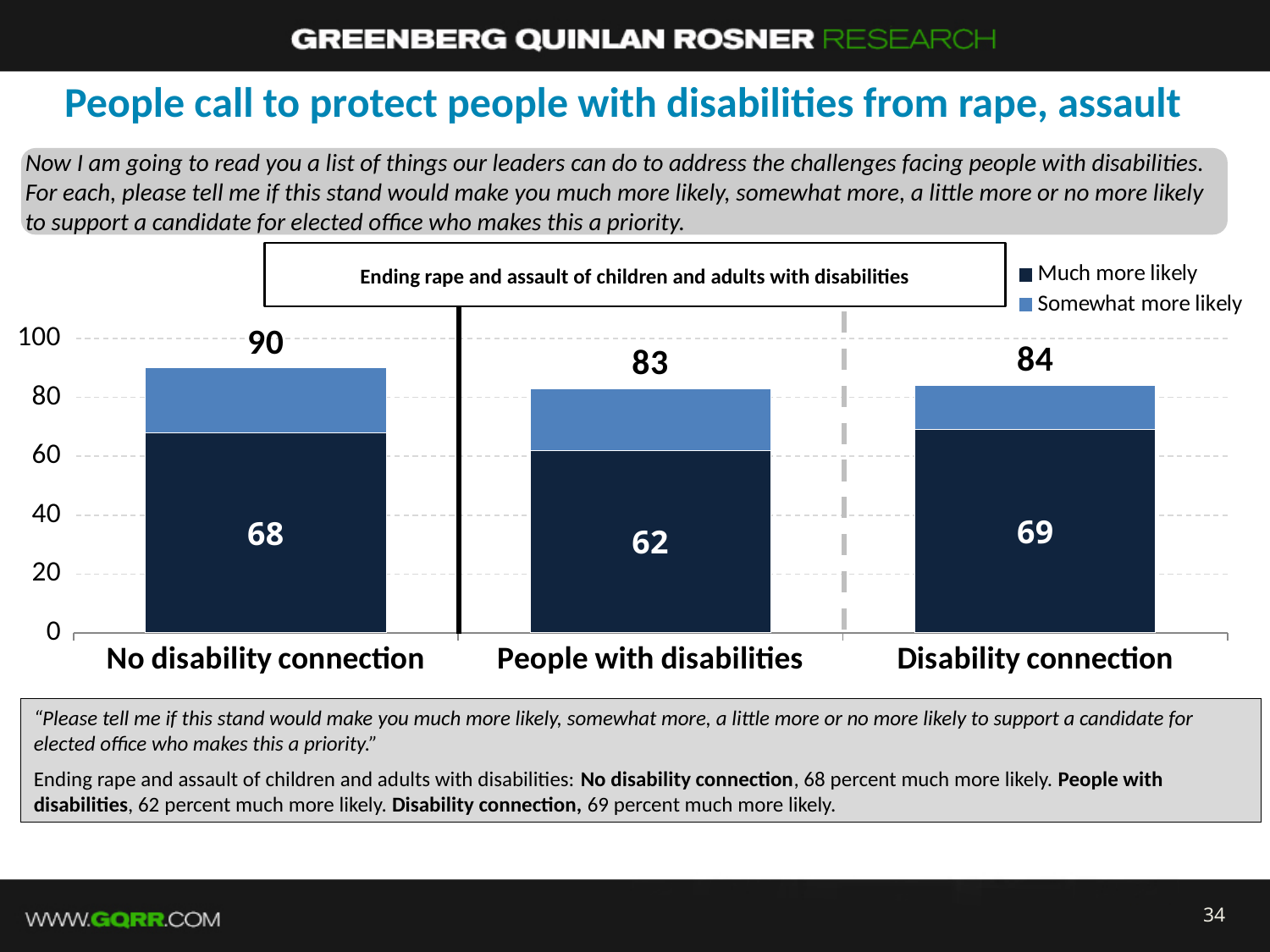
What is the 'Much more likely' value for the People with disabilities group? 62 Which group has the lowest combined total (much more likely plus somewhat more likely)? People with disabilities Which is larger: the total bar for No disability connection or the total bar for Disability connection? No disability connection What is the total of the stacked bar for No disability connection? 90 How many series does the chart legend list? 2 What is the difference between the 'Much more likely' values for Disability connection and People with disabilities? 7 How many groups are shown on the x axis of the chart? 3 What type of chart is shown on the slide? Stacked bar chart Which group has the highest 'Much more likely' value? Disability connection What is the 'Much more likely' value for the Disability connection group? 69 What percentage of people with no disability connection say they are much more likely to support a candidate who prioritizes ending rape and assault of people with disabilities? 68 What is the total of the stacked bar for People with disabilities? 83